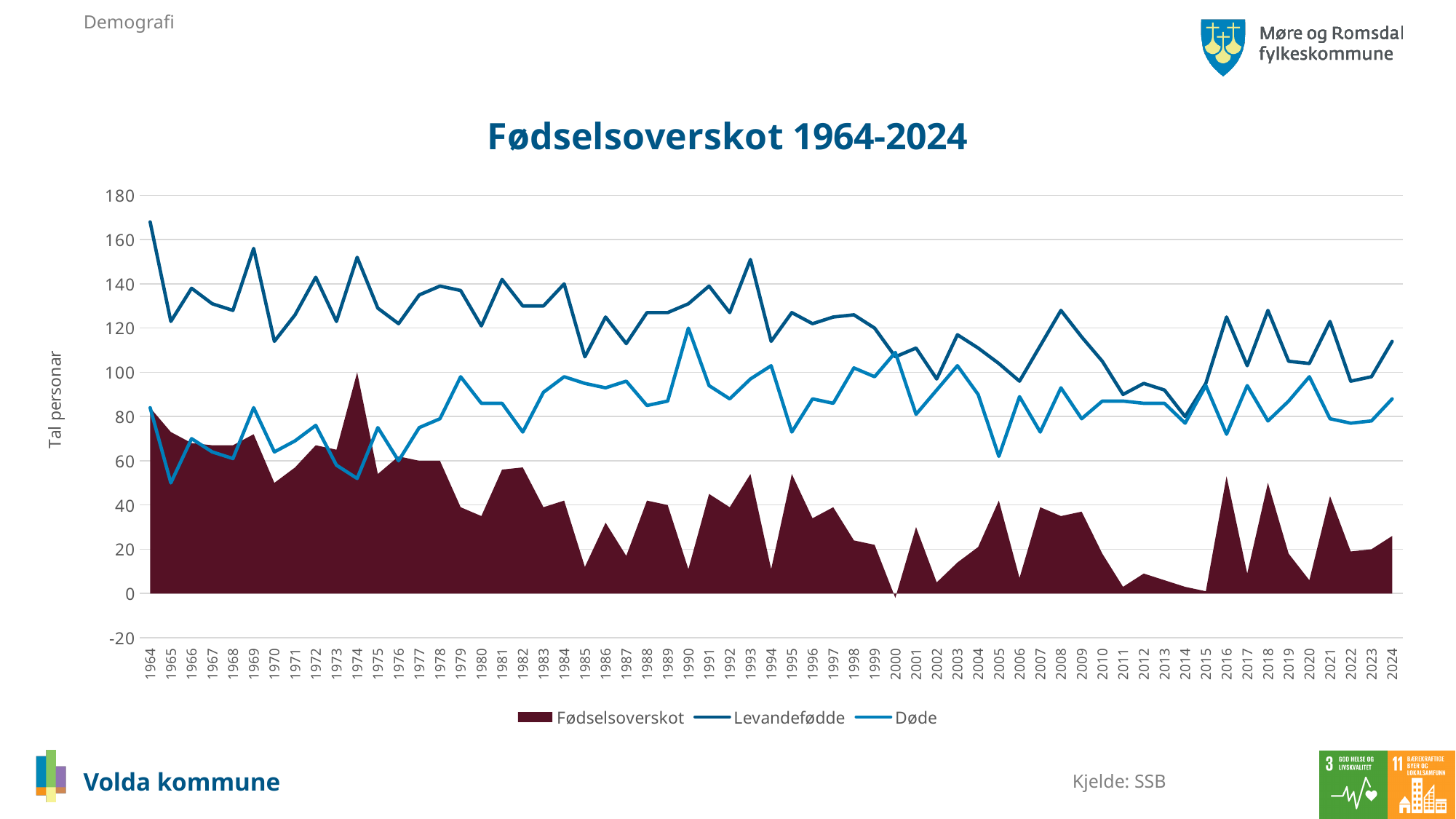
Is the value for Levandefødde in 1964 greater or less than 160? greater Does the Levandefødde series generally rise or fall from 1964 to 2024? fall Which is larger in 2016, Levandefødde or Døde? Levandefødde In which year is the Døde series at its highest? 1990 In which year is the Fødselsoverskot series at its lowest? 2000 How many years are plotted along the x axis? 61 Is the value for Døde in 2005 greater or less than 80? less How many series does the legend list? 3 What is the title of the chart? Fødselsoverskot 1964-2024 What are the three series named in the legend? Fødselsoverskot, Levandefødde, Døde In which year is the Levandefødde series at its highest? 1964 In which year is the Fødselsoverskot series at its highest? 1974